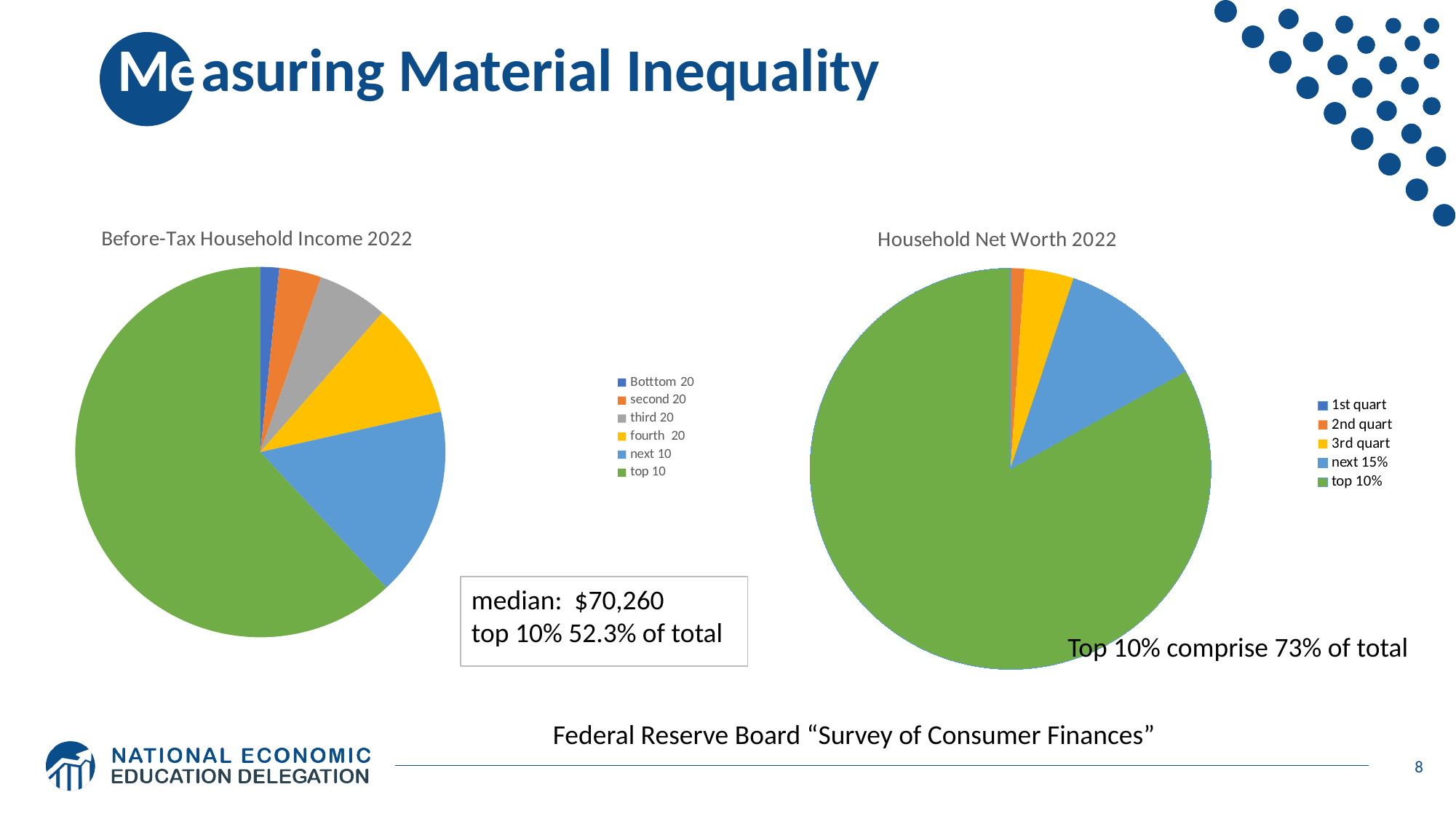
In the Household Net Worth 2022 chart, which category has the smallest slice? 1st quart How many categories does the legend of the Household Net Worth 2022 chart list? 5 In the Household Net Worth 2022 chart, what share of total net worth does the top 10% hold? 73% In the Before-Tax Household Income 2022 chart, which category has the largest slice? top 10 In the Before-Tax Household Income 2022 chart, what share of total income does the top 10% hold? 52.3% What median household income is stated next to the Before-Tax Household Income 2022 chart? $70,260 What colour represents the top 10 category in the Before-Tax Household Income 2022 chart? green In the Household Net Worth 2022 chart, which slice is larger: next 15% or 3rd quart? next 15% In the Household Net Worth 2022 chart, which category has the largest slice? top 10% In the Before-Tax Household Income 2022 chart, which slice is larger: next 10 or fourth 20? next 10 How many categories does the legend of the Before-Tax Household Income 2022 chart list? 6 What type of chart is used for Before-Tax Household Income 2022? pie chart